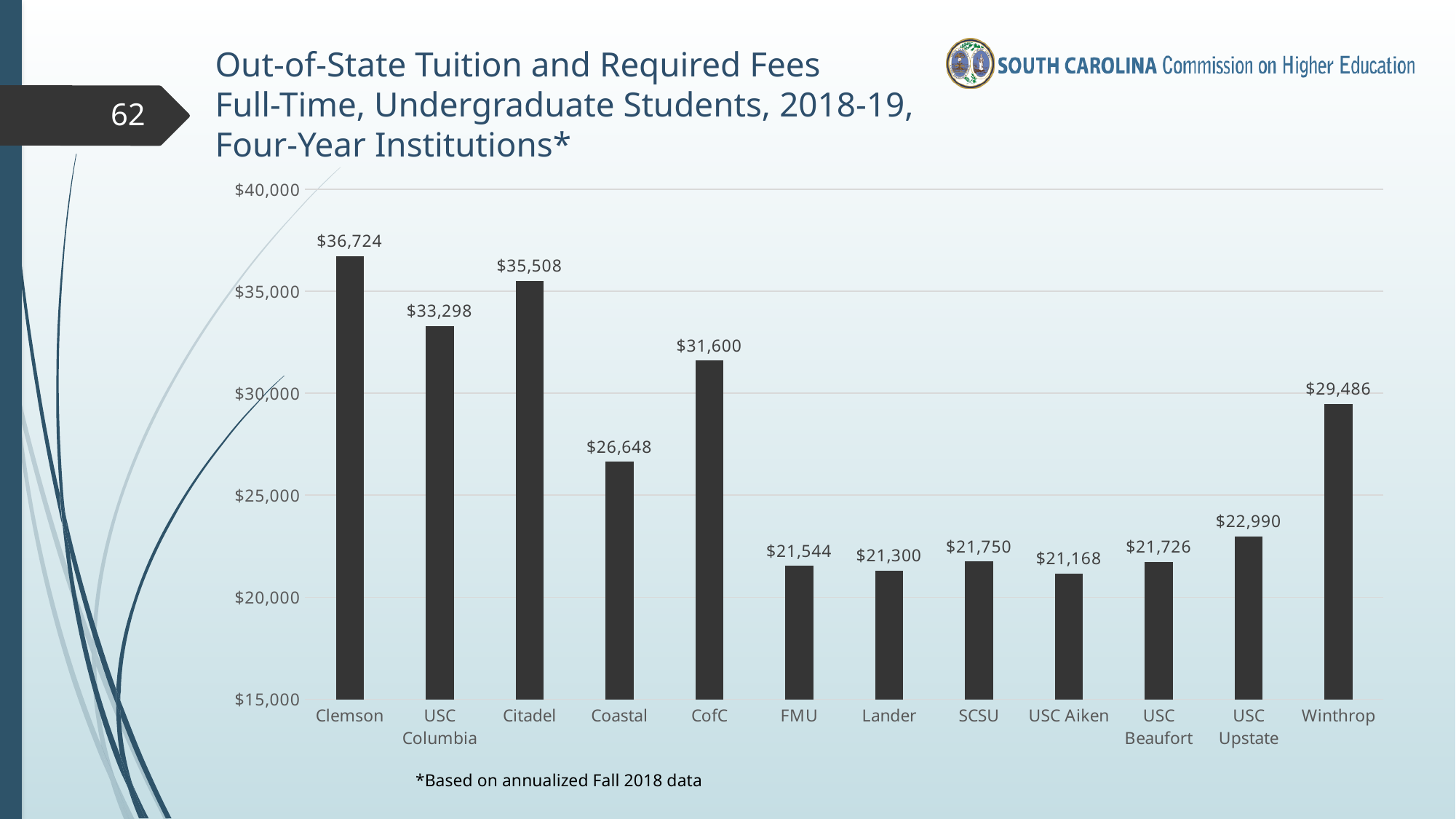
What is the out-of-state tuition and required fees value for Clemson? $36,724 Is the value for Lander greater or less than $25,000? less Which is larger, the value for USC Columbia or the value for CofC? USC Columbia According to the footnote, what data is the chart based on? Annualized Fall 2018 data How many institutions are shown on the chart? 12 What is the value shown for USC Upstate? $22,990 What is the value shown for Winthrop? $29,486 What kind of chart is shown on the slide? bar chart What is the difference between the values for Clemson and Citadel? $1,216 What is the difference between the values for CofC and Coastal? $4,952 Which institution has the highest out-of-state tuition and required fees? Clemson Which institution has the lowest out-of-state tuition and required fees? USC Aiken